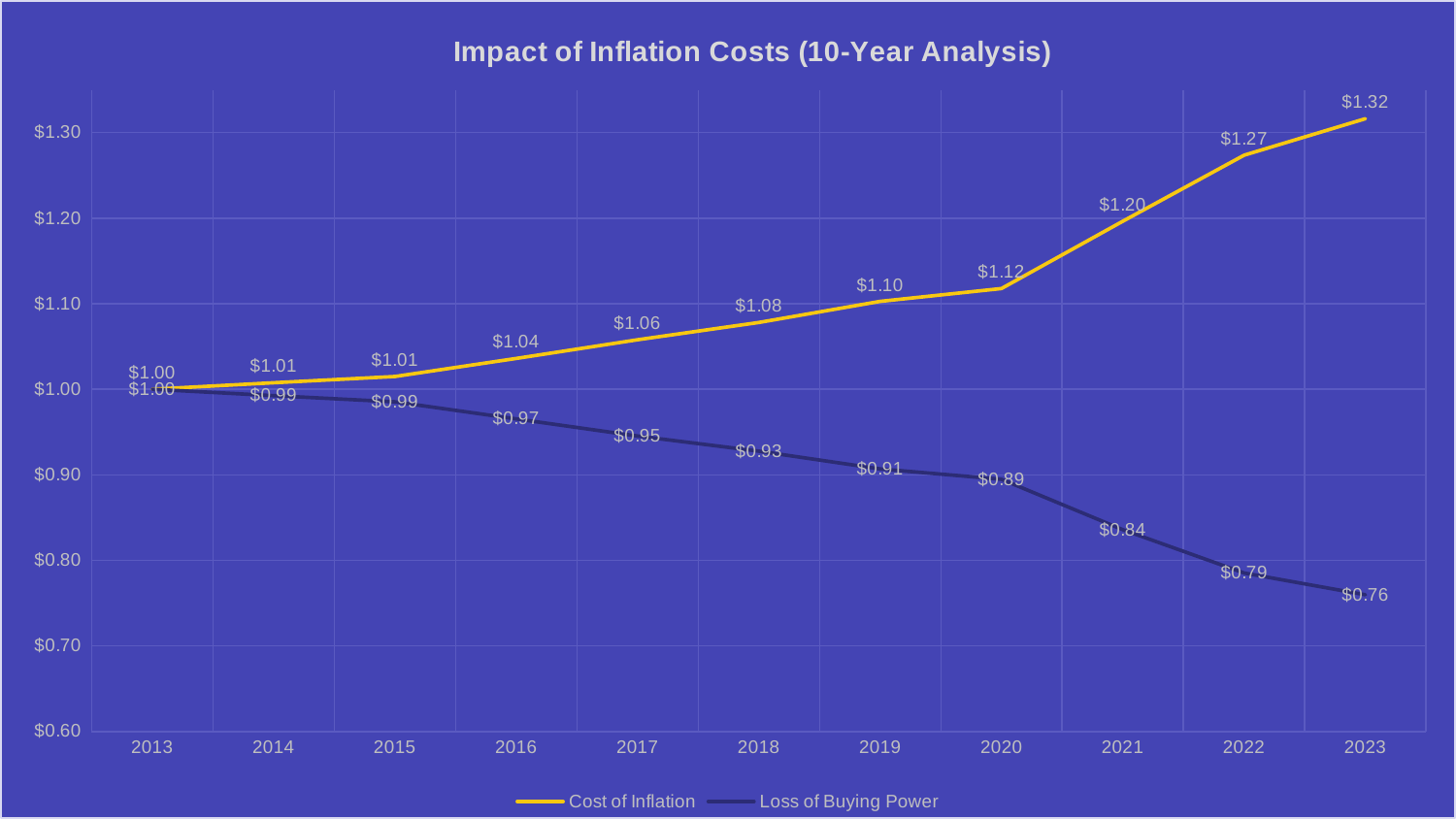
What is the difference between the Cost of Inflation in 2022 and in 2021? $0.07 What is the Cost of Inflation value for 2023? $1.32 Which is larger in 2020: the Cost of Inflation or the Loss of Buying Power? Cost of Inflation In which year is the Cost of Inflation highest? 2023 What kind of chart is shown on the slide? Line chart What is the difference between the Cost of Inflation and the Loss of Buying Power in 2023? $0.56 What is the Cost of Inflation value for 2018? $1.08 How many years are shown on the x axis? 11 How many series does the legend list? 2 Does the Loss of Buying Power rise or fall from 2013 to 2023? Fall In which year is the Loss of Buying Power lowest? 2023 What is the Loss of Buying Power value for 2021? $0.84